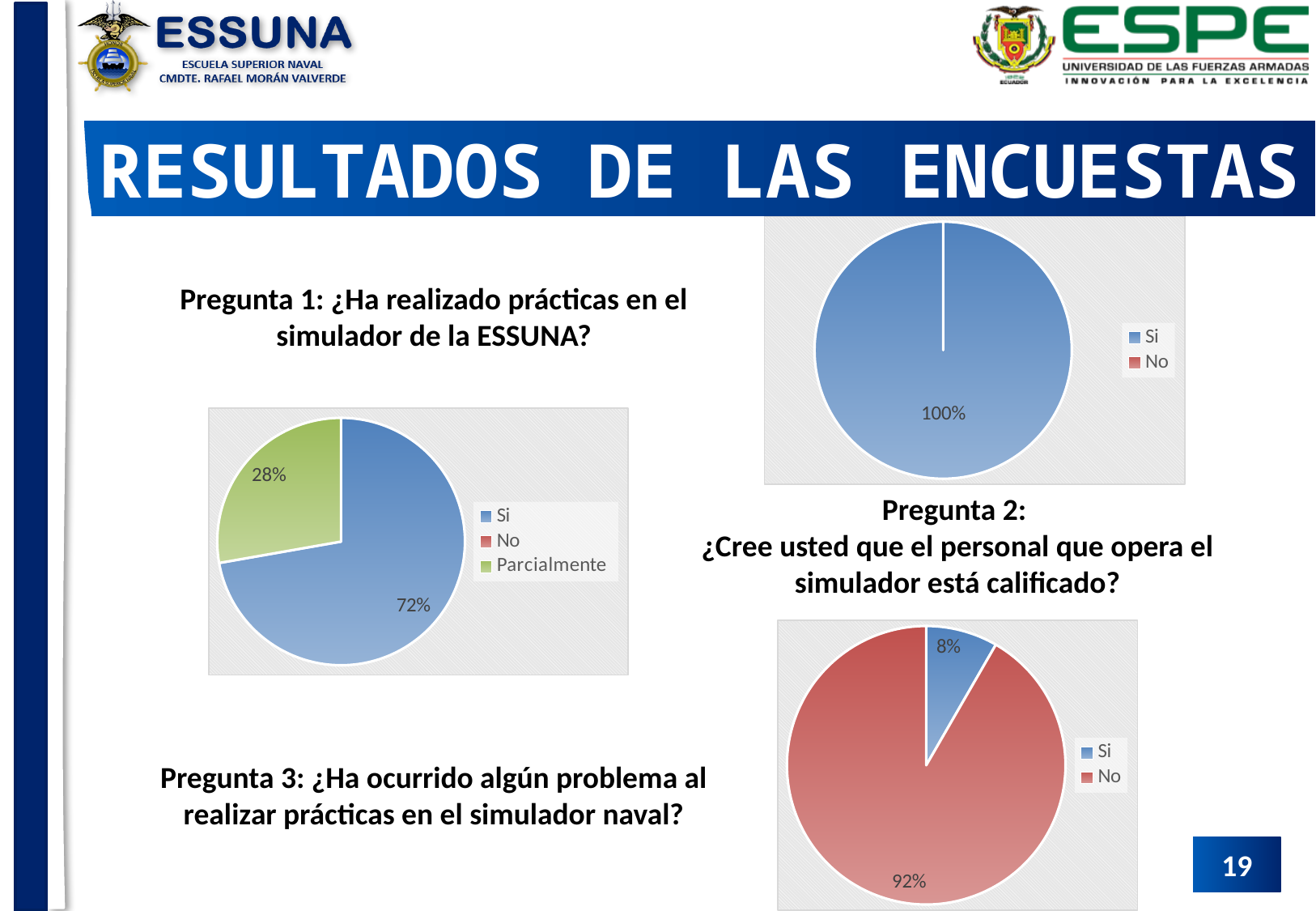
In the pie chart for Pregunta 3 (bottom right), which answer has the smallest slice? Si In the pie chart for Pregunta 3 (bottom right), what share of respondents answered 'No'? 92% In the pie chart for Pregunta 3 (bottom right), what share of respondents answered 'Si'? 8% In the pie chart for Pregunta 1 (left), which answer has the largest slice? Si In the pie chart for Pregunta 1 (left), how many entries does the legend list? 3 In the pie chart for Pregunta 1 (left), what is the difference between the 'Si' and 'Parcialmente' shares? 44% In the pie chart for Pregunta 2 (top right), what share of respondents answered 'Si'? 100% In the pie chart for Pregunta 2 (top right), how many entries does the legend list? 2 In the pie chart for Pregunta 1 (left), what share of respondents answered 'Parcialmente'? 28% What type of chart is used for Pregunta 3 (bottom right)? pie chart In the pie chart for Pregunta 1 (left), what share of respondents answered 'Si'? 72% In the pie chart for Pregunta 3 (bottom right), is the 'No' slice larger or smaller than the 'Si' slice? larger